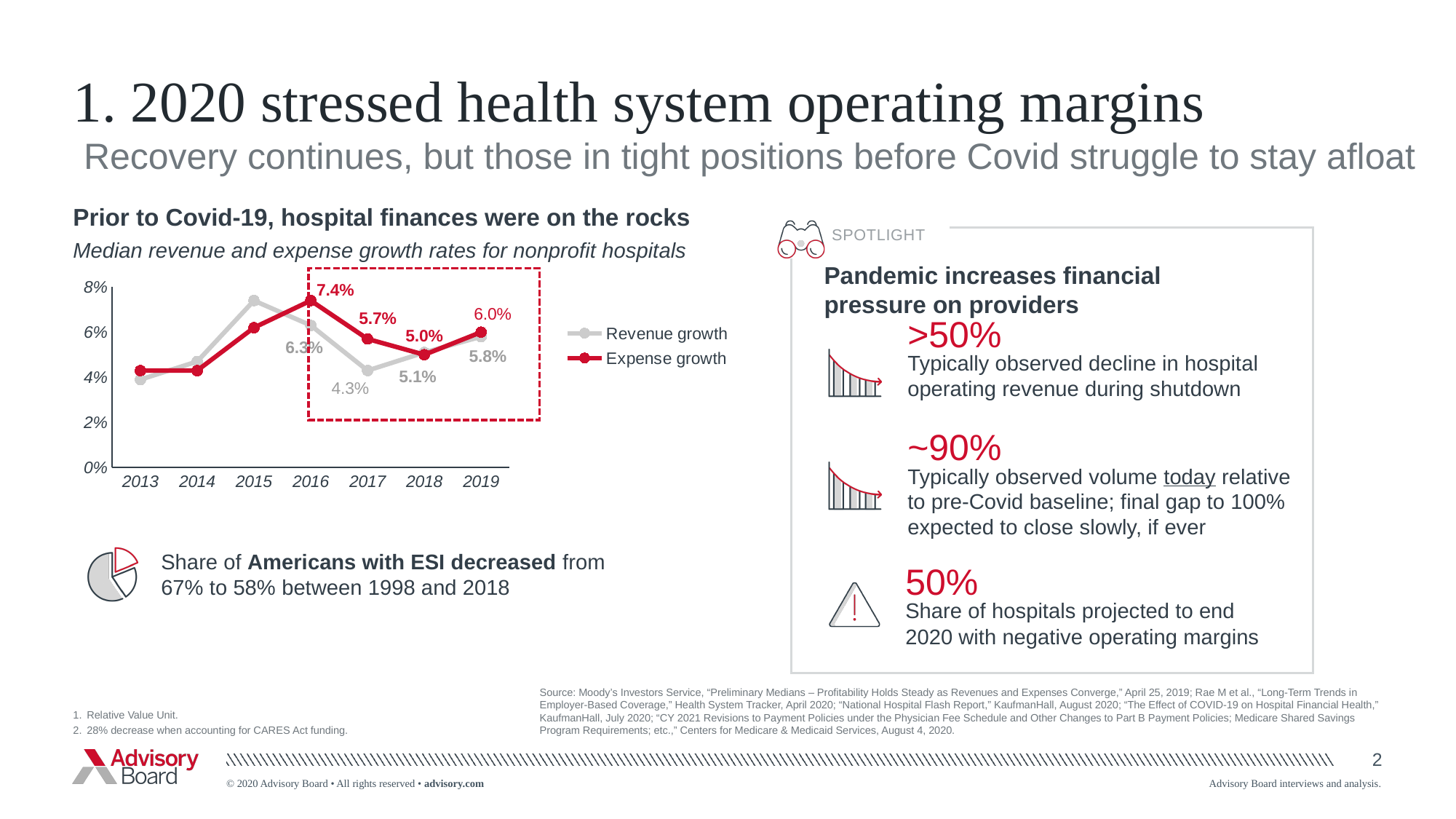
By how many percentage points did expense growth exceed revenue growth in 2016? 1.1 percentage points What was the revenue growth rate in 2018? 5.1% Is the expense growth value for 2013 greater or less than 6%? less What is the difference between expense growth and revenue growth in 2017? 1.4 percentage points What was the median revenue growth rate in 2017? 4.3% In 2017, which was larger: revenue growth or expense growth? Expense growth What was the median expense growth rate for nonprofit hospitals in 2016? 7.4% In which year did expense growth reach its highest value? 2016 How many series does the chart's legend list? 2 What was the expense growth rate in 2019? 6.0% How many years are shown on the x axis of the chart? 7 Is the revenue growth value for 2015 greater or less than 6%? greater